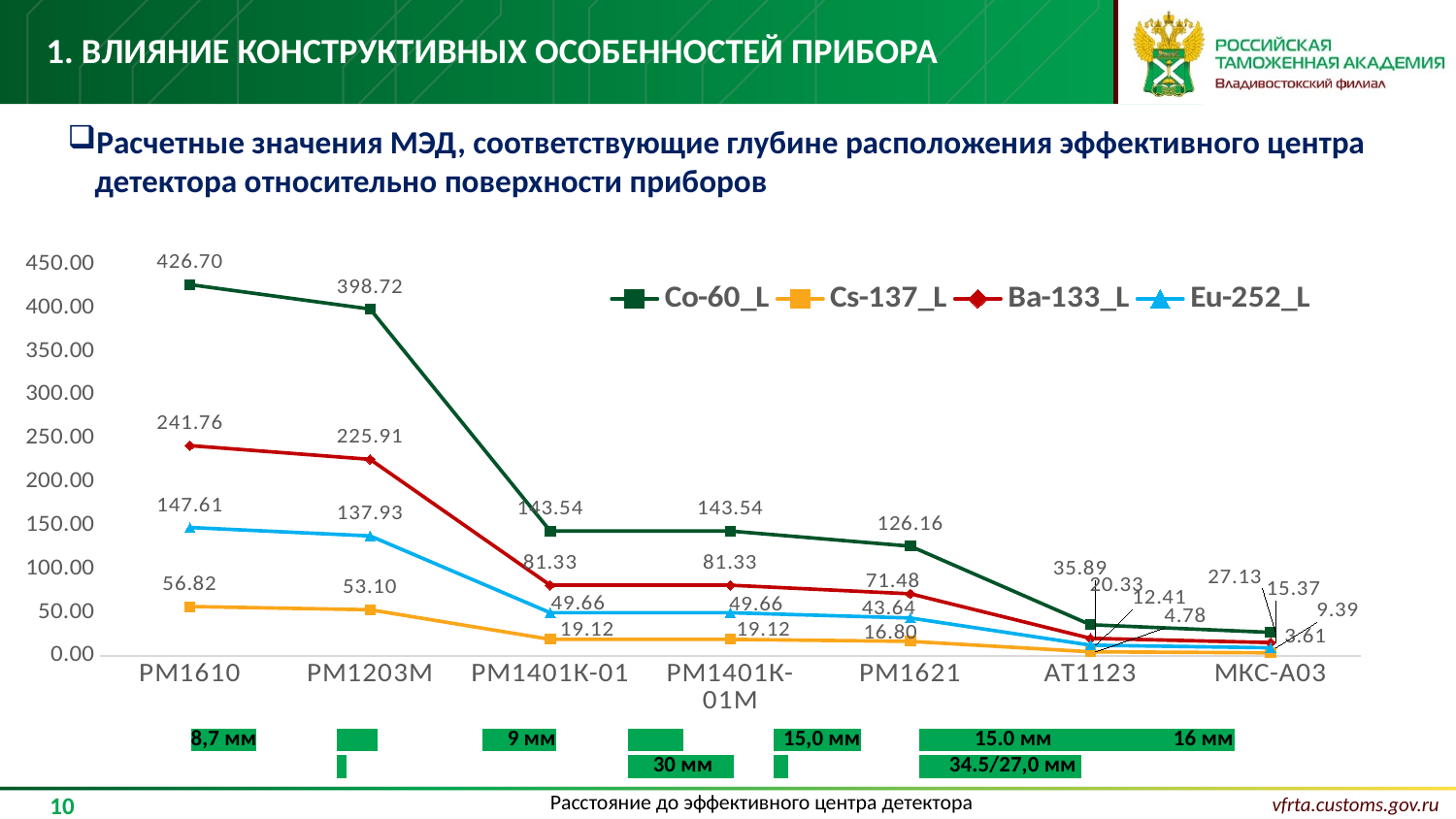
How many series does the legend list? 4 Which is larger: the Ba-133_L value for PM1401K-01 or the Eu-252_L value for PM1610? Eu-252_L value for PM1610 Which category has the lowest Eu-252_L value? MKC-A03 What is the difference between the Co-60_L values for PM1610 and PM1203M? 27.98 Does the Co-60_L series rise or fall from PM1610 to MKC-A03? fall What kind of chart is shown on the slide? line chart What is the value of the Co-60_L series for PM1610? 426.70 How many categories are shown on the x axis? 7 What is the value of the Ba-133_L series for PM1203M? 225.91 What is the value of the Cs-137_L series for PM1621? 16.80 Which category has the highest Co-60_L value? PM1610 Is the Co-60_L value for PM1621 greater or less than 100.00? greater